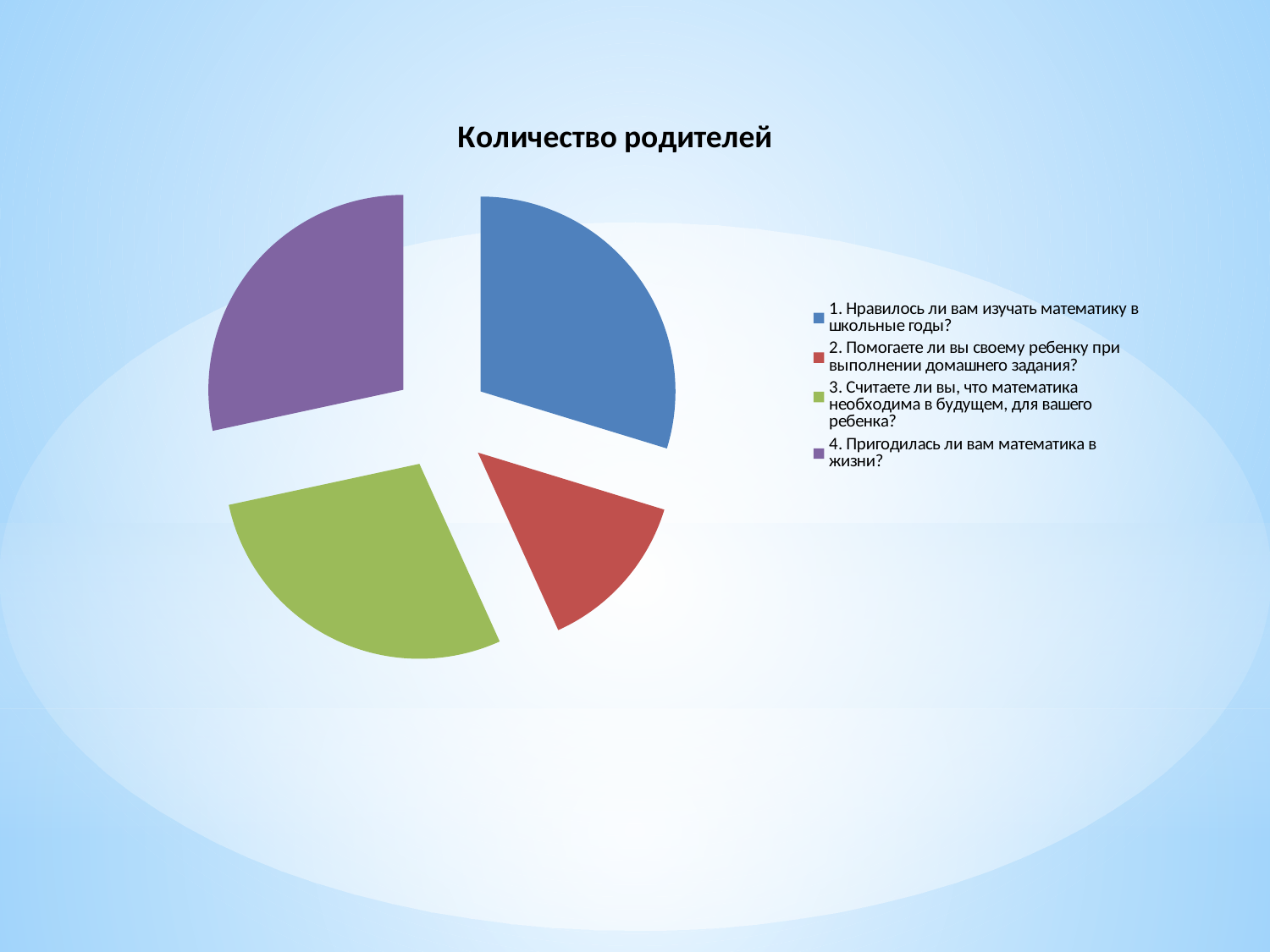
What is the title of the chart? Количество родителей Which slice is larger: "4. Пригодилась ли вам математика в жизни?" or "2. Помогаете ли вы своему ребенку при выполнении домашнего задания?"? 4. Пригодилась ли вам математика в жизни? Which category has the smallest slice of the pie? 2. Помогаете ли вы своему ребенку при выполнении домашнего задания? Which slice is larger: "3. Считаете ли вы, что математика необходима в будущем, для вашего ребенка?" or "2. Помогаете ли вы своему ребенку при выполнении домашнего задания?"? 3. Считаете ли вы, что математика необходима в будущем, для вашего ребенка? How many entries does the legend list? 4 What colour is the slice for "4. Пригодилась ли вам математика в жизни?"? purple Which slice is larger: "1. Нравилось ли вам изучать математику в школьные годы?" or "2. Помогаете ли вы своему ребенку при выполнении домашнего задания?"? 1. Нравилось ли вам изучать математику в школьные годы? What kind of chart is shown on the slide? pie chart How many slices does the pie chart have? 4